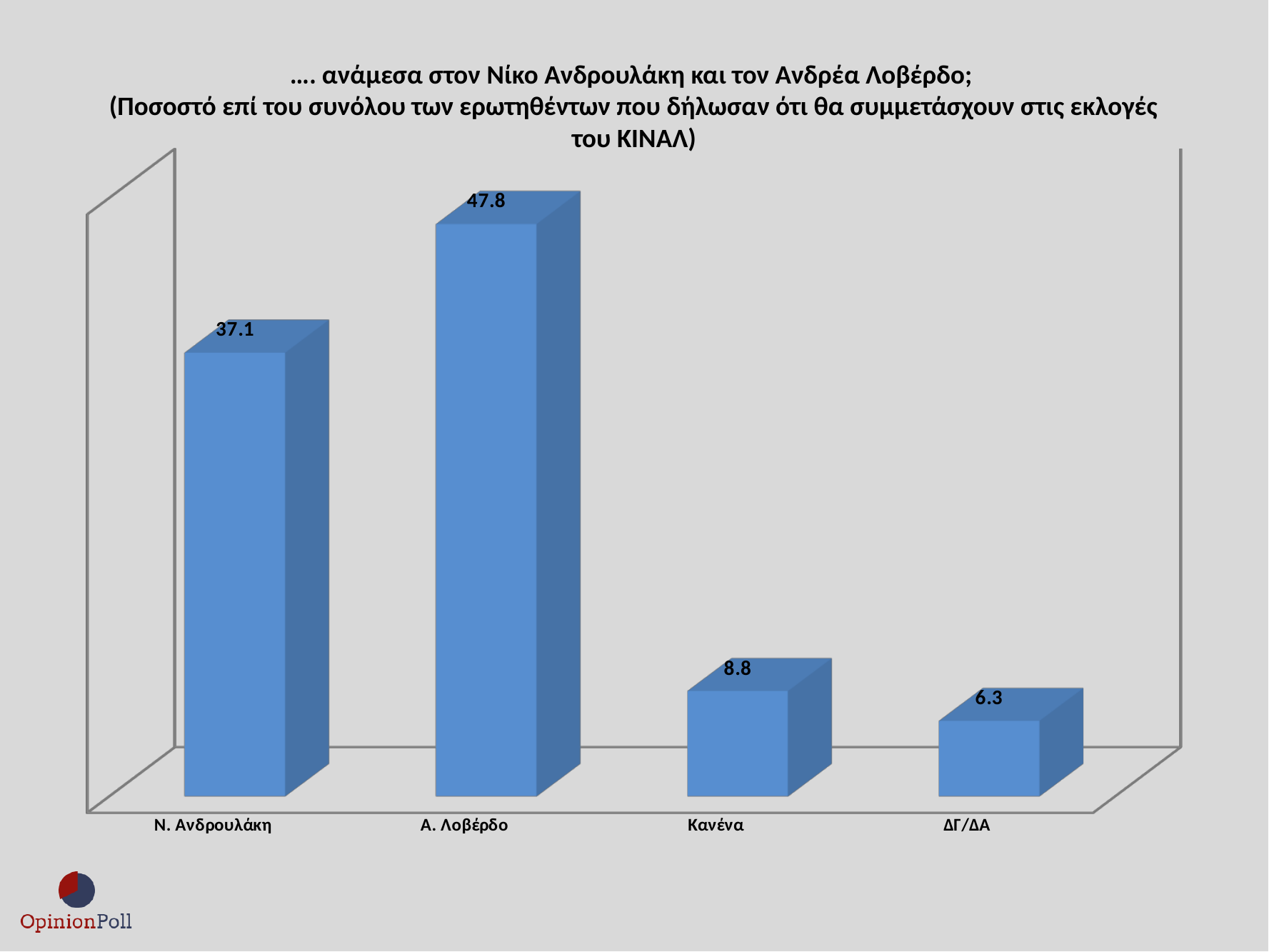
How many categories are shown on the chart? 4 What kind of chart is shown on the slide? Bar chart What is the difference between the values for Α. Λοβέρδο and Ν. Ανδρουλάκη? 10.7 What colour are the bars in the chart? Blue What is the value for Κανένα? 8.8 What is the value for ΔΓ/ΔΑ? 6.3 What is the value for Ν. Ανδρουλάκη? 37.1 Which category has the lowest value? ΔΓ/ΔΑ Which is larger, the value for Ν. Ανδρουλάκη or the value for Κανένα? Ν. Ανδρουλάκη Which category has the highest value? Α. Λοβέρδο What is the difference between the values for Κανένα and ΔΓ/ΔΑ? 2.5 What is the value for Α. Λοβέρδο? 47.8